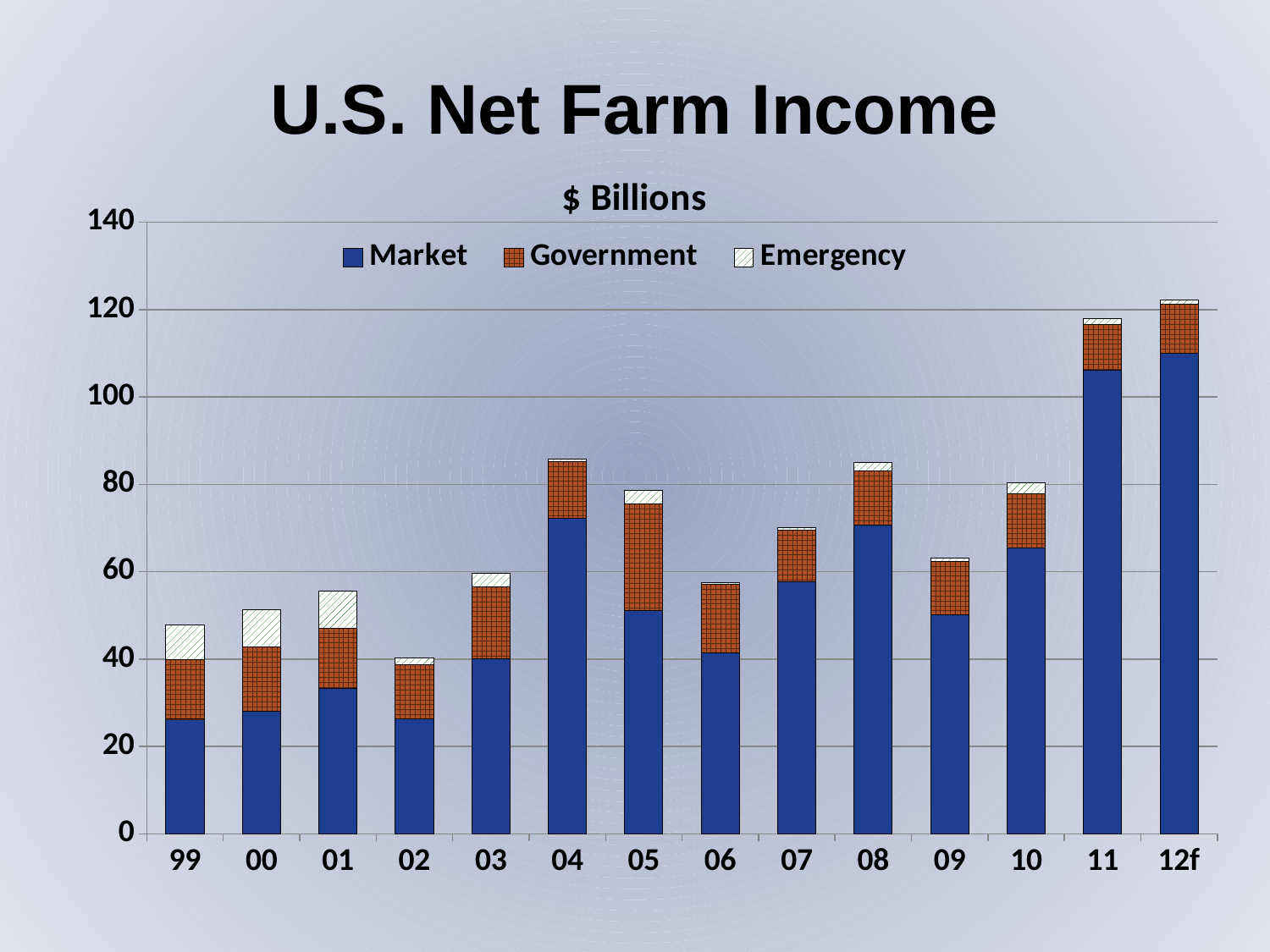
Is the total value for 02 greater or less than 60? less Which year has the larger total, 04 or 05? 04 Is the total value for 11 greater or less than 100? greater What unit is given in the chart subtitle? $ Billions How many series does the legend list? 3 Is the Market value for 99 greater or less than 40? less Do the total values rise or fall from 09 to 12f? rise Which year has the highest total net farm income? 12f Which year has the lowest total net farm income? 02 What kind of chart is shown on the slide? stacked bar chart How many years are shown along the x axis? 14